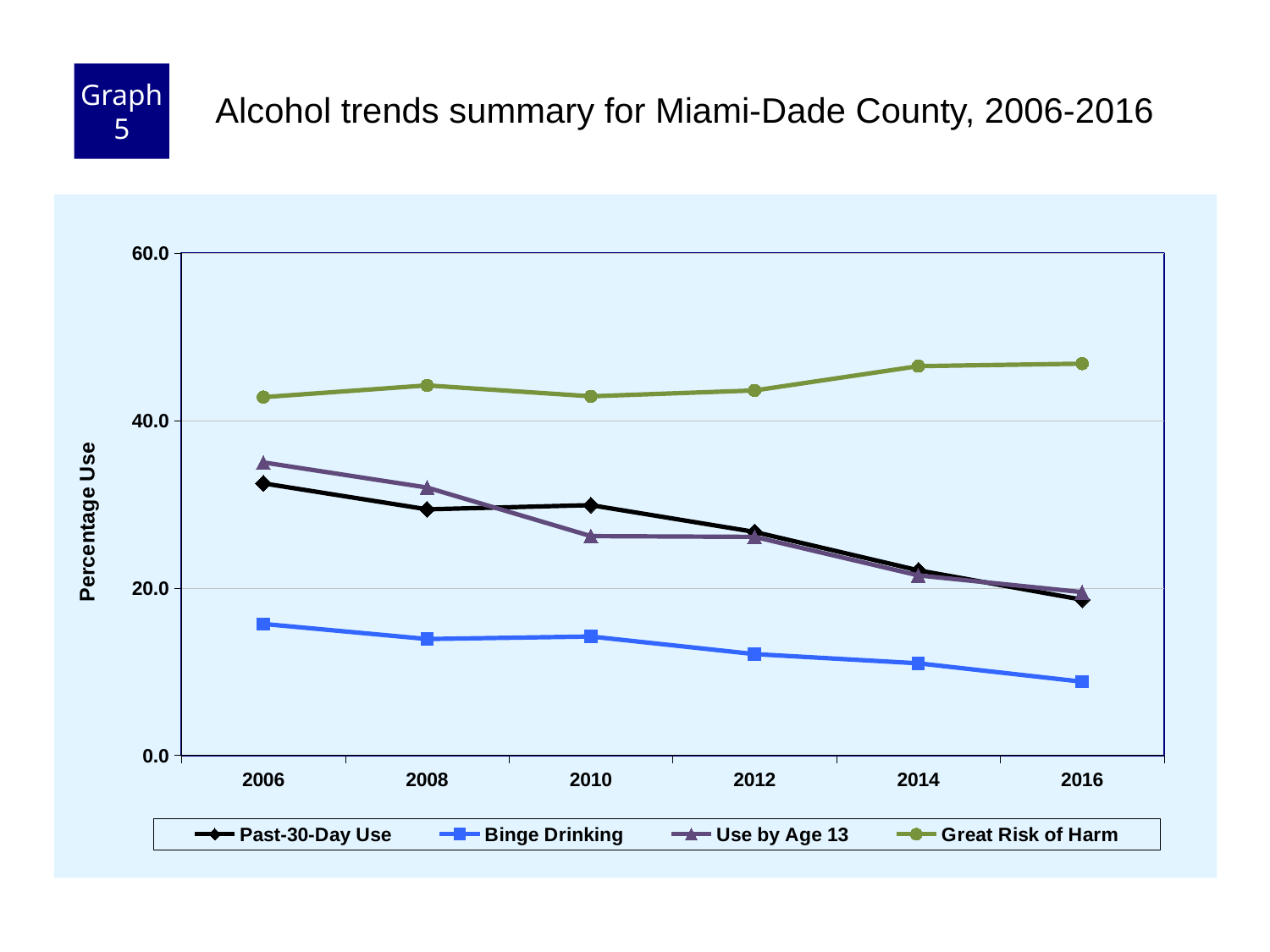
Is the value for Past-30-Day Use in 2006 greater or less than 20.0? greater What is the label on the y axis? Percentage Use In 2010, which is larger: Past-30-Day Use or Use by Age 13? Past-30-Day Use What kind of chart is shown on the slide? line chart Which series has the highest value in 2016? Great Risk of Harm How many series does the legend list? 4 Which series has the lowest value in 2012? Binge Drinking Is the value for Binge Drinking in 2006 greater or less than 20.0? less Does the Binge Drinking line rise or fall from 2006 to 2016? fall How many years are plotted along the x axis? 6 Is the value for Great Risk of Harm in 2016 greater or less than 40.0? greater Does the Great Risk of Harm line rise or fall overall from 2006 to 2016? rise